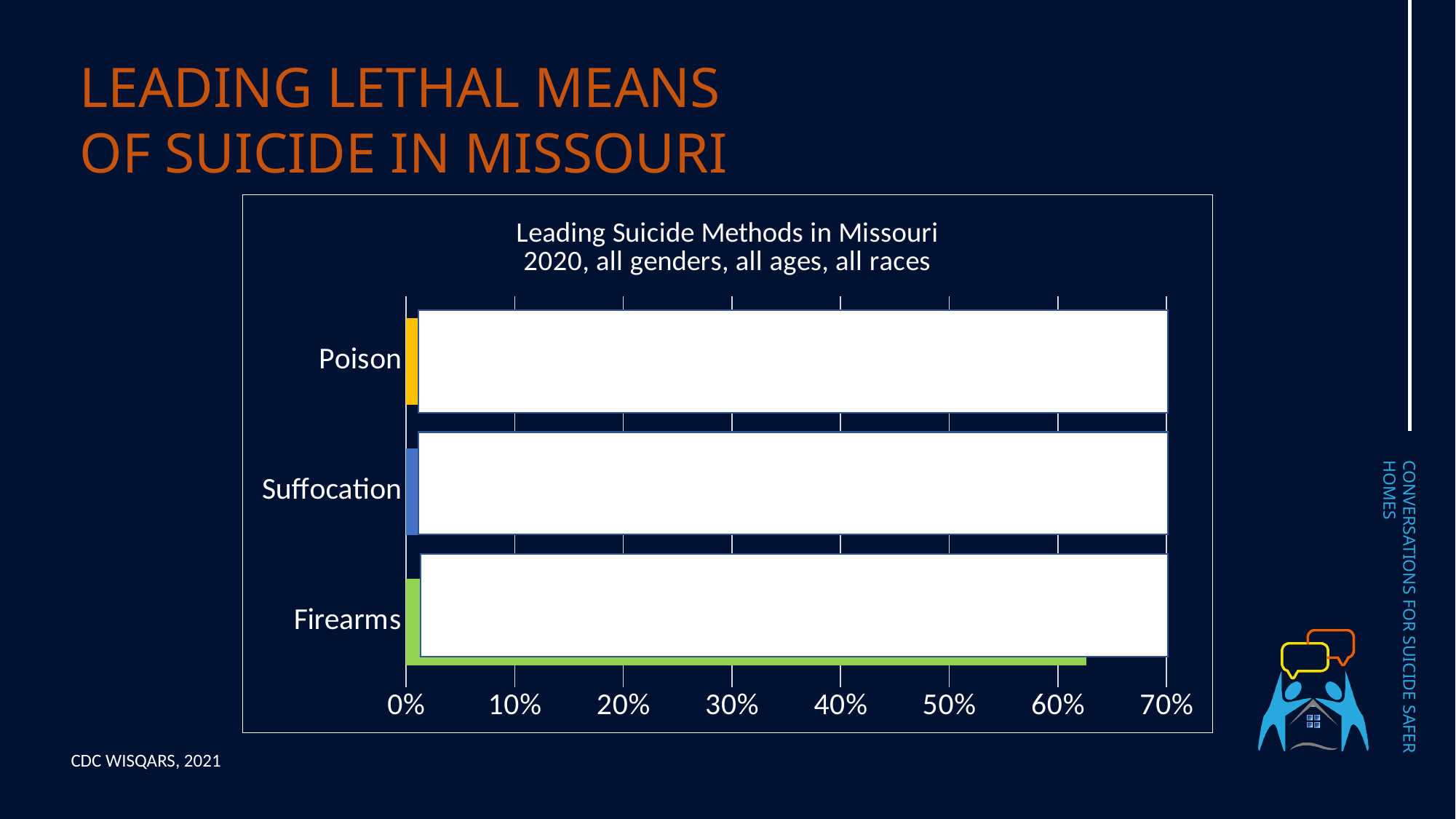
Is the value for Firearms greater or less than 60%? greater What kind of chart is shown on the slide? bar chart Is the value for Firearms greater or less than 50%? greater What is the title of the chart? Leading Suicide Methods in Missouri 2020, all genders, all ages, all races Which category is listed at the top of the chart? Poison What is the highest value shown on the horizontal axis? 70% Is the value for Firearms greater or less than 70%? less How many categories are shown on the chart? 3 What are the three categories shown on the chart? Poison, Suffocation, Firearms